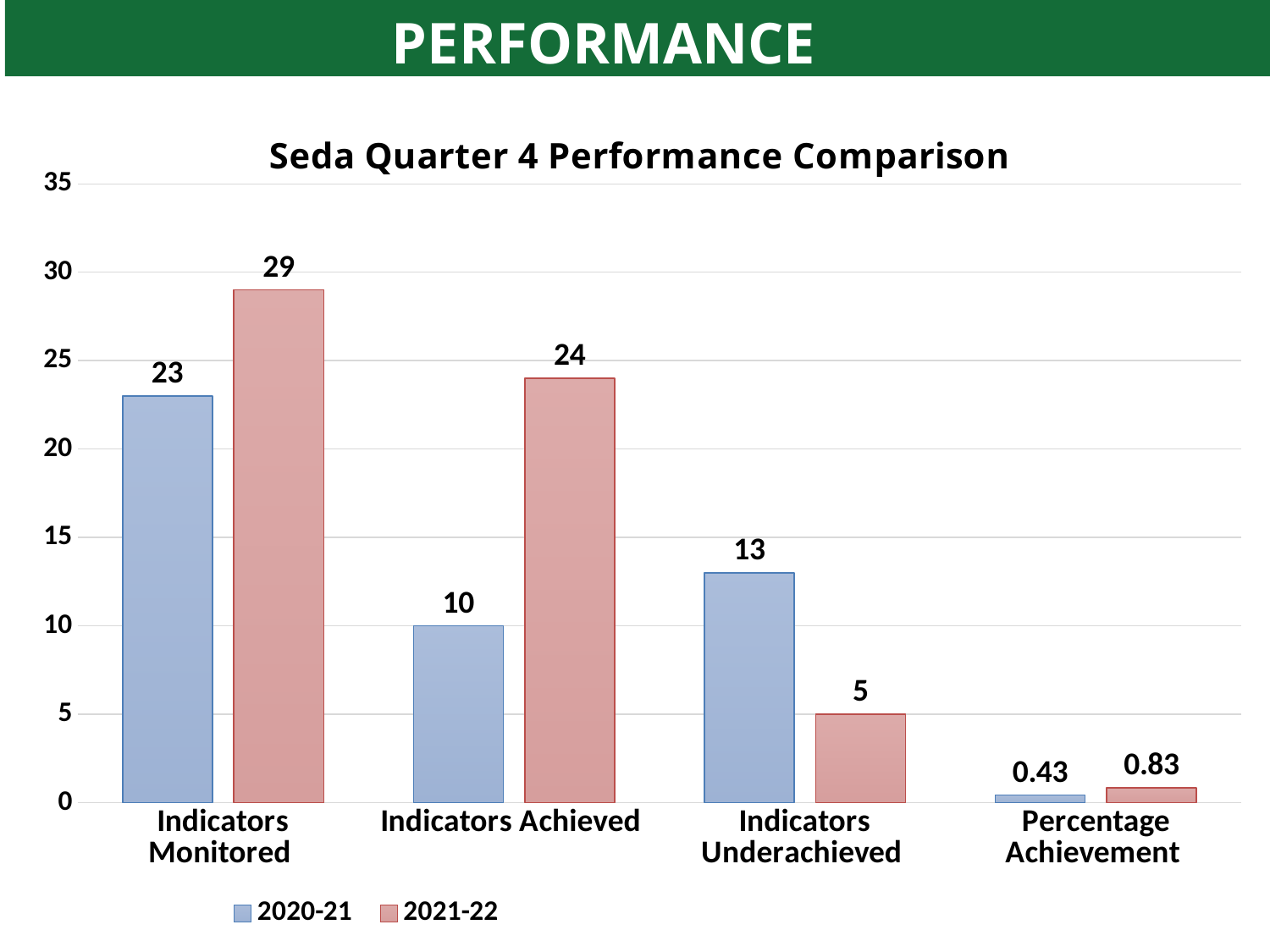
Which is larger for Indicators Monitored: the 2020-21 value or the 2021-22 value? 2021-22 What kind of chart is shown on the slide? Bar chart Which category has the highest value for the 2021-22 series? Indicators Monitored What is the value for Indicators Underachieved in 2020-21? 13 What is the value for Indicators Monitored in 2020-21? 23 How many categories are shown on the x axis? 4 What is the difference between the 2021-22 and 2020-21 values for Indicators Achieved? 14 How many series does the legend list? 2 Which category has the lowest value for the 2020-21 series? Percentage Achievement What is the difference between the 2020-21 and 2021-22 values for Indicators Underachieved? 8 What is the value for Percentage Achievement in 2021-22? 0.83 What is the value for Indicators Achieved in 2021-22? 24